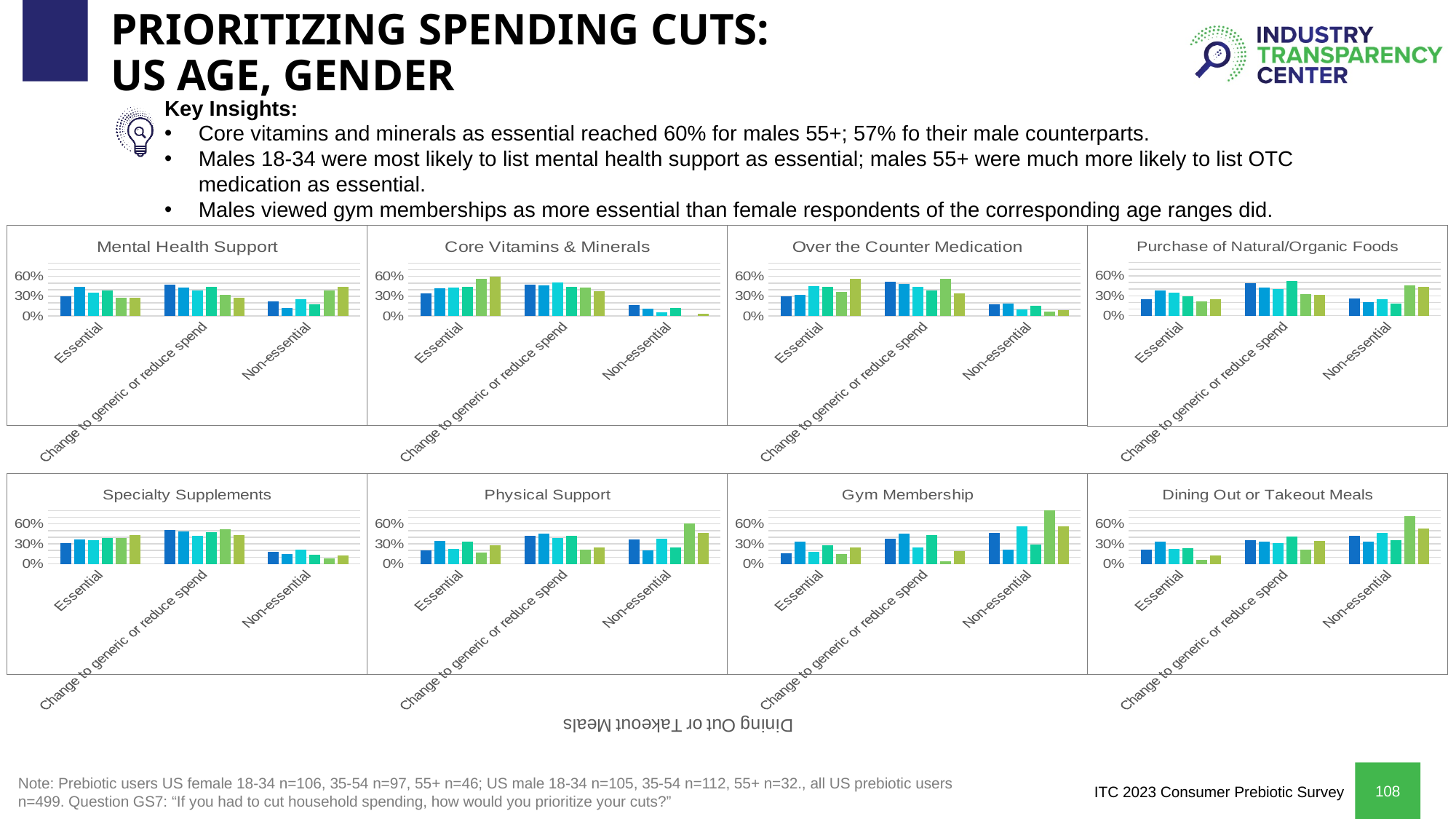
In the "Gym Membership" chart, which category contains the tallest bar? Non-essential In the "Core Vitamins & Minerals" chart, which category contains the tallest bar? Essential What is the title of the chart in the top-right position of the slide? Purchase of Natural/Organic Foods In the "Dining Out or Takeout Meals" chart, is the tallest bar in the Non-essential category greater or less than 60%? greater How many charts are shown on the slide? 8 In the "Core Vitamins & Minerals" chart, are all the bars in the Non-essential category greater or less than 30%? less How many categories are shown on the x axis of the "Gym Membership" chart? 3 In the "Physical Support" chart, which category contains the tallest bar? Non-essential In the "Gym Membership" chart, is the tallest bar in the Non-essential category greater or less than 60%? greater What kind of chart is the "Mental Health Support" chart? bar chart